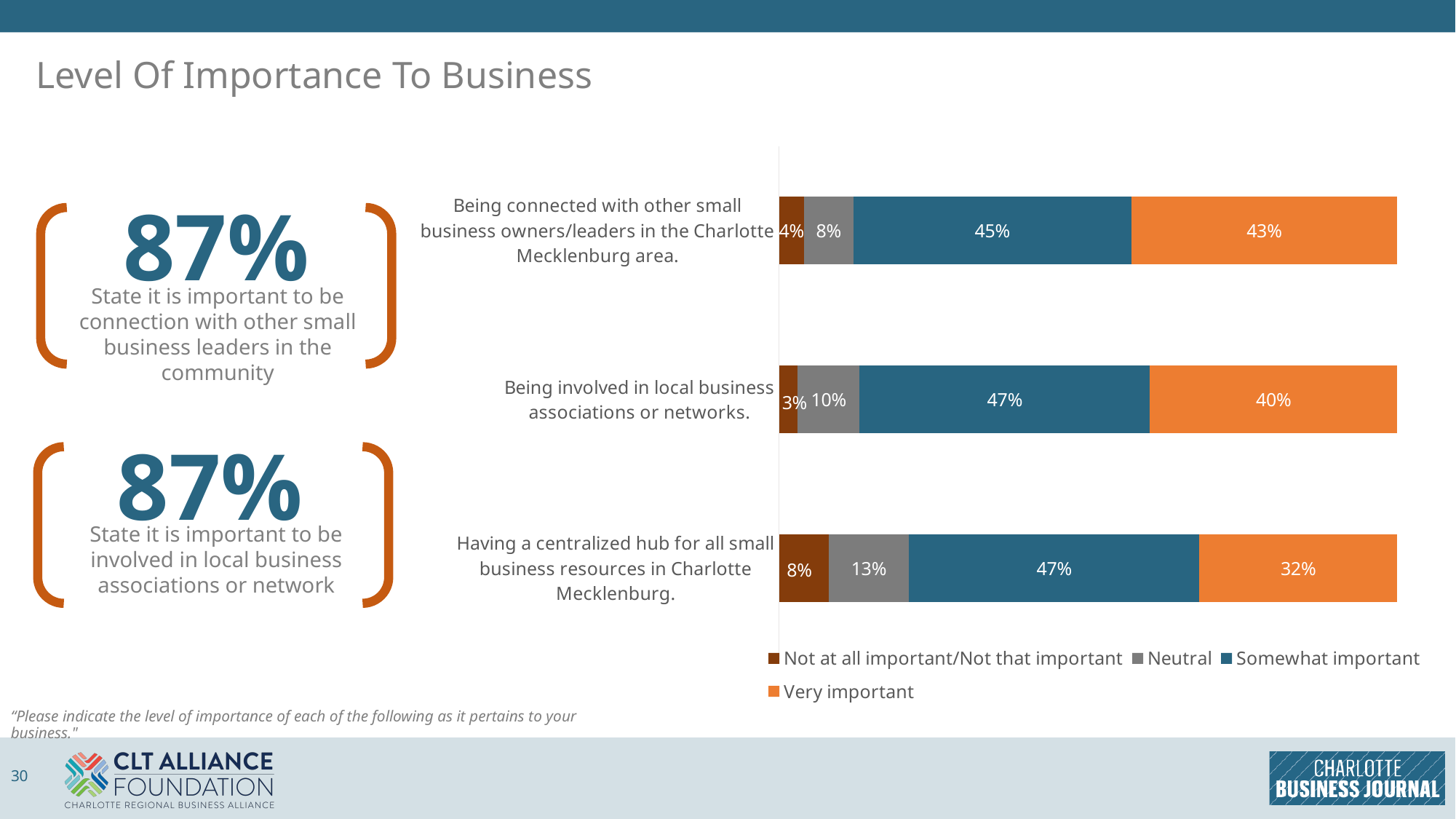
What percentage of respondents rated being connected with other small business owners/leaders in the Charlotte Mecklenburg area as very important? 43% How many categories are shown in the chart? 3 What is the Somewhat important value for having a centralized hub for all small business resources in Charlotte Mecklenburg? 47% What is the difference between the Very important percentages for being connected with other small business owners/leaders and having a centralized hub for all small business resources? 11% How many series does the legend list? 4 Which category has the highest Very important percentage? Being connected with other small business owners/leaders in the Charlotte Mecklenburg area. Which category has the lowest Not at all important/Not that important percentage? Being involved in local business associations or networks. What is the Neutral value for being involved in local business associations or networks? 10% What is the combined Somewhat important and Very important percentage for being involved in local business associations or networks? 87% What kind of chart is shown on the slide? Stacked bar chart What share of respondents said having a centralized hub for all small business resources in Charlotte Mecklenburg is not at all important/not that important? 8% Which is larger: the Neutral value for having a centralized hub for all small business resources, or the Neutral value for being connected with other small business owners/leaders? Having a centralized hub for all small business resources in Charlotte Mecklenburg.